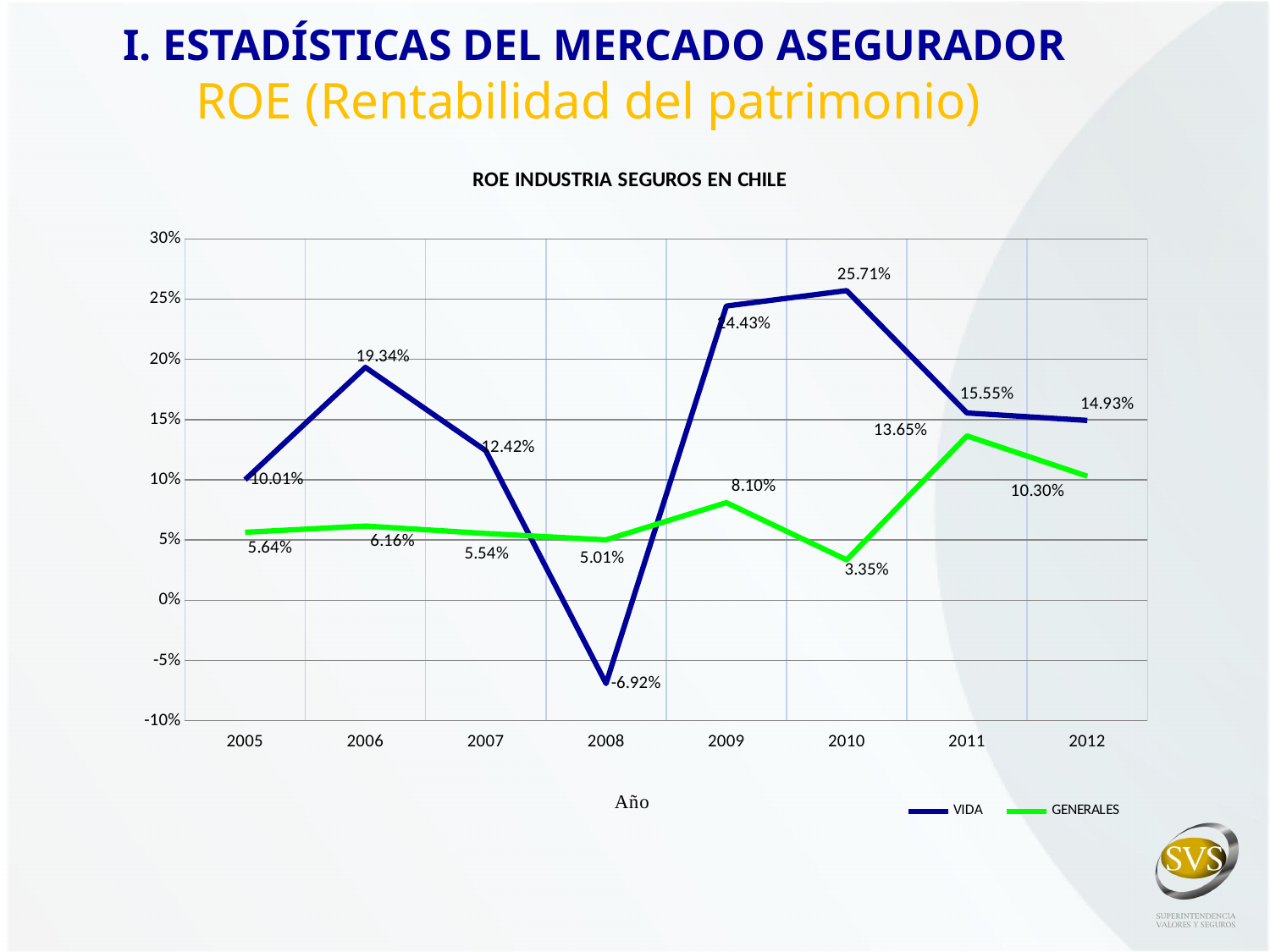
Does the GENERALES series rise or fall from 2011 to 2012? fall What is the title of the chart? ROE INDUSTRIA SEGUROS EN CHILE What is the ROE for VIDA in 2008? -6.92% In which year is the VIDA series at its highest? 2010 What is the ROE for GENERALES in 2011? 13.65% Which series has the higher value in 2008, VIDA or GENERALES? GENERALES What is the ROE for VIDA in 2010? 25.71% What type of chart is shown on the slide? line chart In which year is the GENERALES series at its lowest? 2010 What is the difference between the VIDA and GENERALES values in 2012? 4.63% How many series does the legend list? 2 How many years are plotted on the x axis? 8